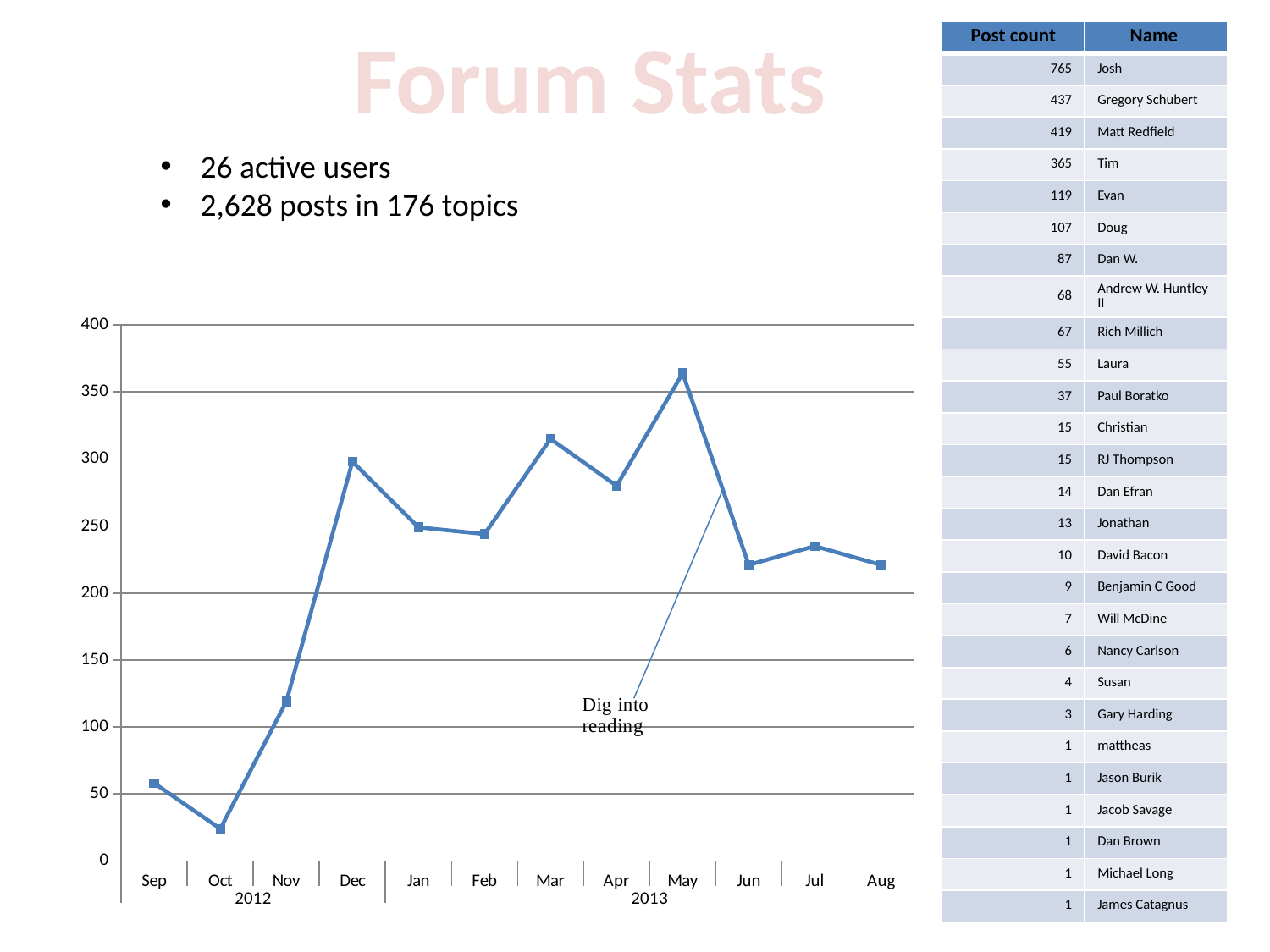
Is the value for Sep greater or less than 100? less Which month has the highest value on the chart? May Which month has the lowest value on the chart? Oct What kind of chart is shown on the slide? line chart What does the annotation text on the chart say? Dig into reading Which is larger, the value for Nov or the value for Dec? Dec How many monthly data points are plotted on the chart? 12 Do the values rise or fall from Oct to Dec? rise Is the value for Dec greater or less than 250? greater Is the value for Apr greater or less than 300? less Which is larger, the value for Mar or the value for Apr? Mar